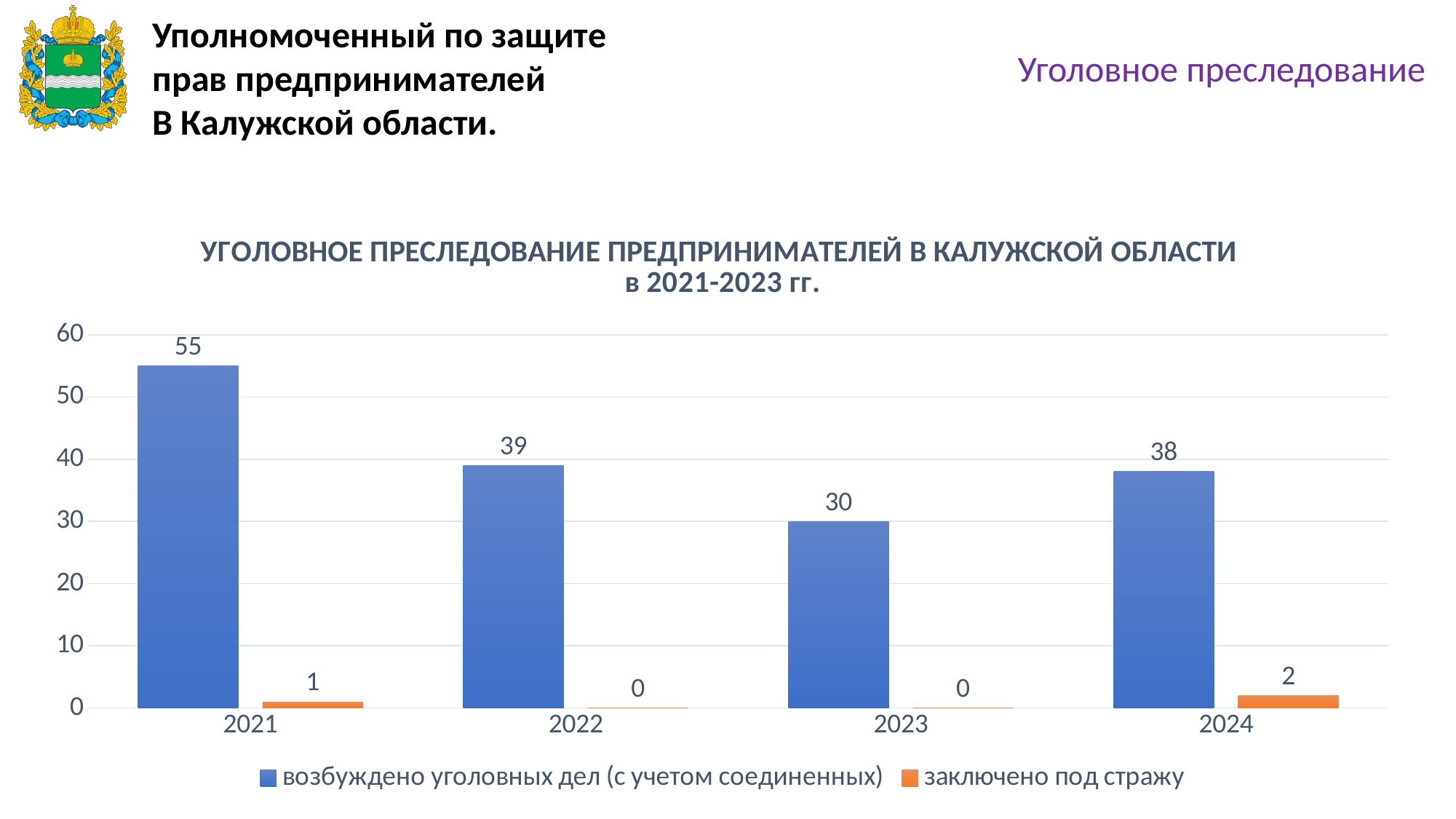
What is the title of the chart? УГОЛОВНОЕ ПРЕСЛЕДОВАНИЕ ПРЕДПРИНИМАТЕЛЕЙ В КАЛУЖСКОЙ ОБЛАСТИ в 2021-2023 гг. What is the difference between the 'возбуждено уголовных дел (с учетом соединенных)' values for 2021 and 2022? 16 Which is larger: the 'возбуждено уголовных дел (с учетом соединенных)' value for 2022 or for 2024? 2022 What is the value for 'возбуждено уголовных дел (с учетом соединенных)' in 2023? 30 How many years are shown on the x axis? 4 What is the value for 'возбуждено уголовных дел (с учетом соединенных)' in 2021? 55 Is the value for 'возбуждено уголовных дел (с учетом соединенных)' in 2023 greater or less than 40? less Which year has the lowest value for 'возбуждено уголовных дел (с учетом соединенных)'? 2023 How many series does the legend list? 2 What kind of chart is shown on the slide? bar chart What is the value for 'заключено под стражу' in 2024? 2 Which year has the highest value for 'возбуждено уголовных дел (с учетом соединенных)'? 2021